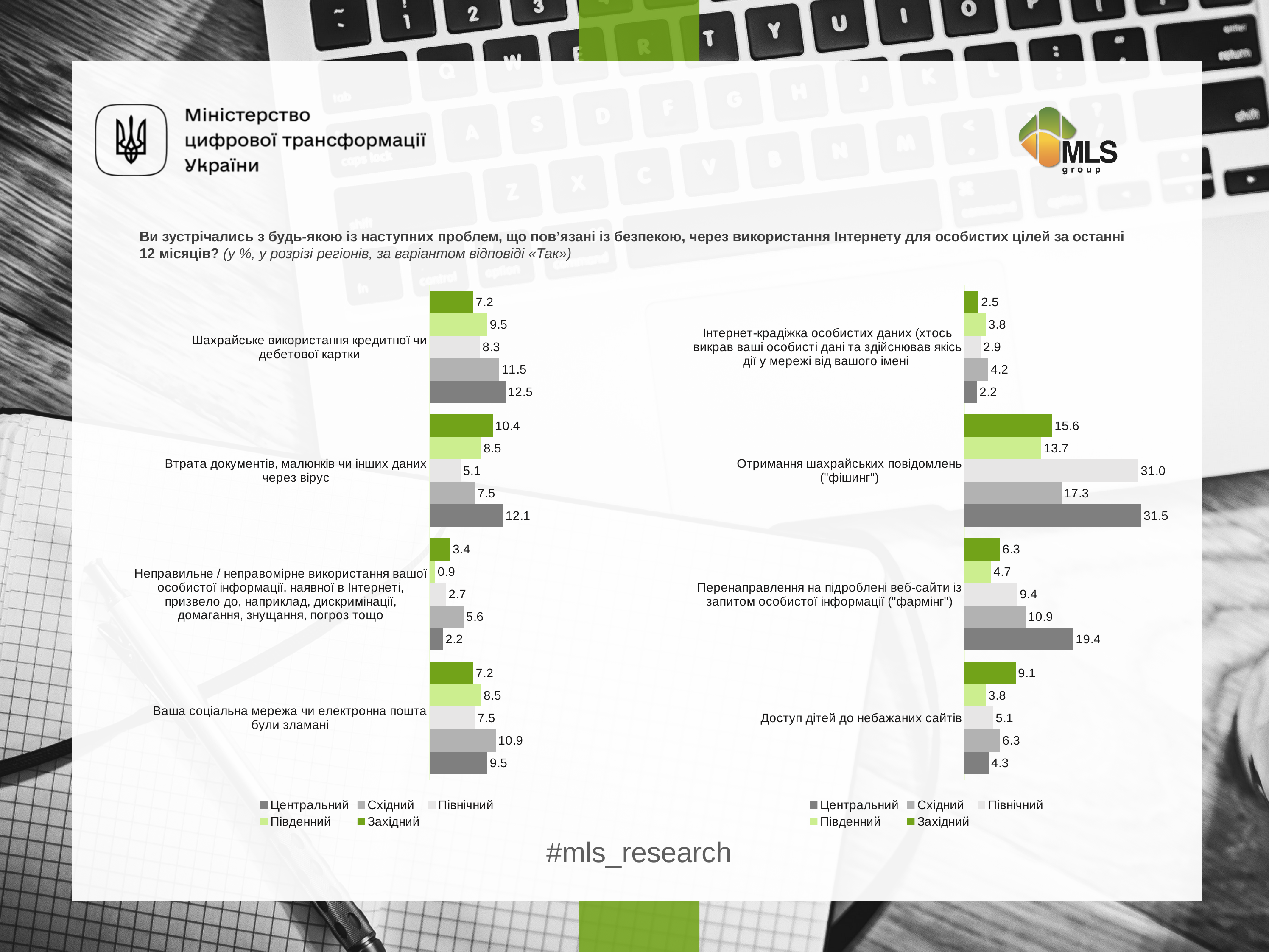
On the left chart, which is larger for «Ваша соціальна мережа чи електронна пошта були зламані»: Східний or Центральний? Східний On the right chart, what is the value for Північний for «Отримання шахрайських повідомлень ("фішинг")»? 31.0 On the right chart, which is larger for «Інтернет-крадіжка особистих даних...»: Східний or Центральний? Східний On the left chart, what is the value for Центральний for «Шахрайське використання кредитної чи дебетової картки»? 12.5 On the right chart, which region has the highest value for «Перенаправлення на підроблені веб-сайти із запитом особистої інформації ("фармінг")»? Центральний On the right chart, what is the value for Західний for «Доступ дітей до небажаних сайтів»? 9.1 How many categories are shown on the right chart? 4 On the left chart, what is the difference between Центральний and Західний for «Втрата документів, малюнків чи інших даних через вірус»? 1.7 On the left chart, which region has the lowest value for «Неправильне / неправомірне використання вашої особистої інформації...»? Південний What type of chart is the left chart? Bar chart How many series does the legend of the left chart list? 5 On the right chart, what is the difference between Центральний and Східний for «Перенаправлення на підроблені веб-сайти... ("фармінг")»? 8.5